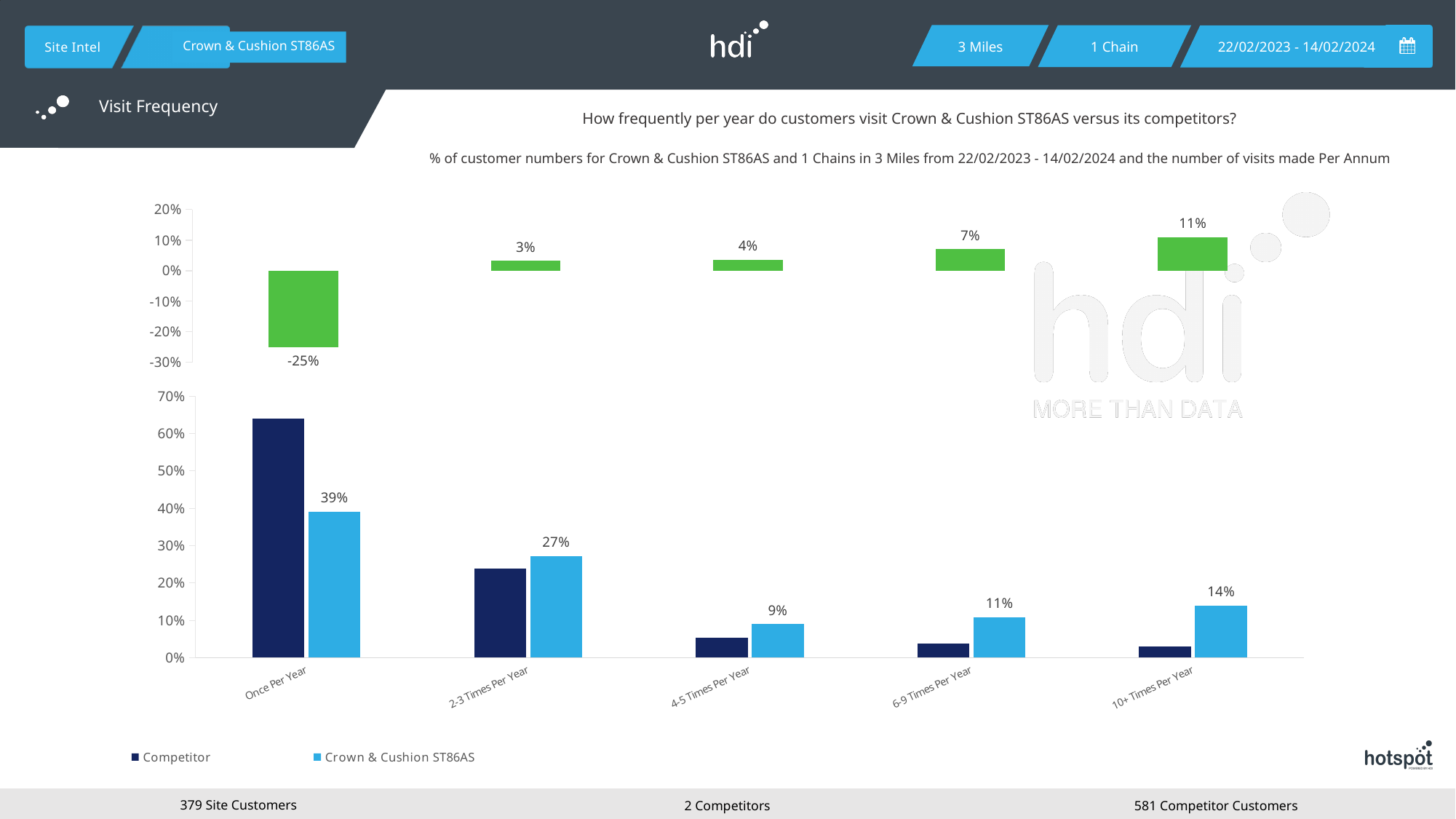
On the bottom chart, what is the value for Crown & Cushion ST86AS in the 10+ Times Per Year category? 14% On the bottom chart, which category has the highest Crown & Cushion ST86AS value? Once Per Year On the bottom chart, is the Competitor value for 4-5 Times Per Year greater or less than 10%? less On the bottom chart, what is the value for Crown & Cushion ST86AS in the Once Per Year category? 39% How many series does the legend of the bottom chart list? 2 On the bottom chart, what is the difference between the Crown & Cushion ST86AS values for Once Per Year and 2-3 Times Per Year? 12% On the top chart, what is the value shown for the Once Per Year category? -25% On the bottom chart, is the Competitor value for Once Per Year greater or less than 60%? greater On the bottom chart, which series has the larger value for Once Per Year, Competitor or Crown & Cushion ST86AS? Competitor On the bottom chart, which category has the lowest Crown & Cushion ST86AS value? 4-5 Times Per Year On the top chart, which category has the highest value? 10+ Times Per Year On the bottom chart, what is the value for Crown & Cushion ST86AS in the 2-3 Times Per Year category? 27%